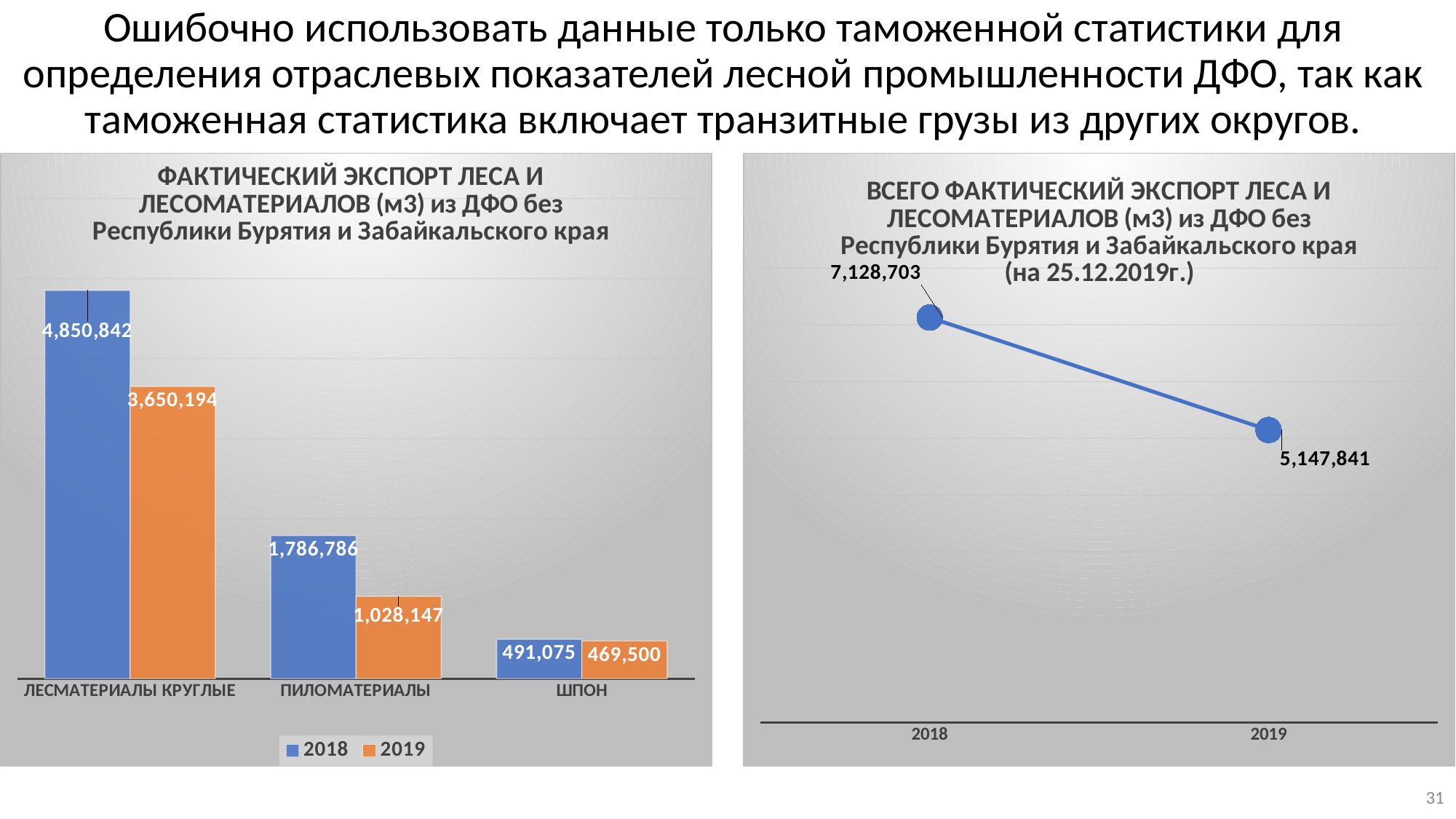
In the left bar chart, what is the 2019 value for ПИЛОМАТЕРИАЛЫ? 1,028,147 In the left bar chart, what is the difference between the 2018 and 2019 values for ЛЕСМАТЕРИАЛЫ КРУГЛЫЕ? 1,200,648 How many series does the legend of the left bar chart list? 2 In the right line chart, what is the difference between the 2018 and 2019 values? 1,980,862 In the left bar chart, which category has the lowest 2019 value? ШПОН In the right line chart, what is the value for 2019? 5,147,841 What kind of chart is the chart on the right of the slide? line chart In the left bar chart, which is larger for ПИЛОМАТЕРИАЛЫ: the 2018 value or the 2019 value? 2018 In the left bar chart, what is the 2018 value for ЛЕСМАТЕРИАЛЫ КРУГЛЫЕ? 4,850,842 In the left bar chart, what is the 2019 value for ШПОН? 469,500 How many categories are shown on the x axis of the left bar chart? 3 In the left bar chart, which category has the highest 2018 value? ЛЕСМАТЕРИАЛЫ КРУГЛЫЕ